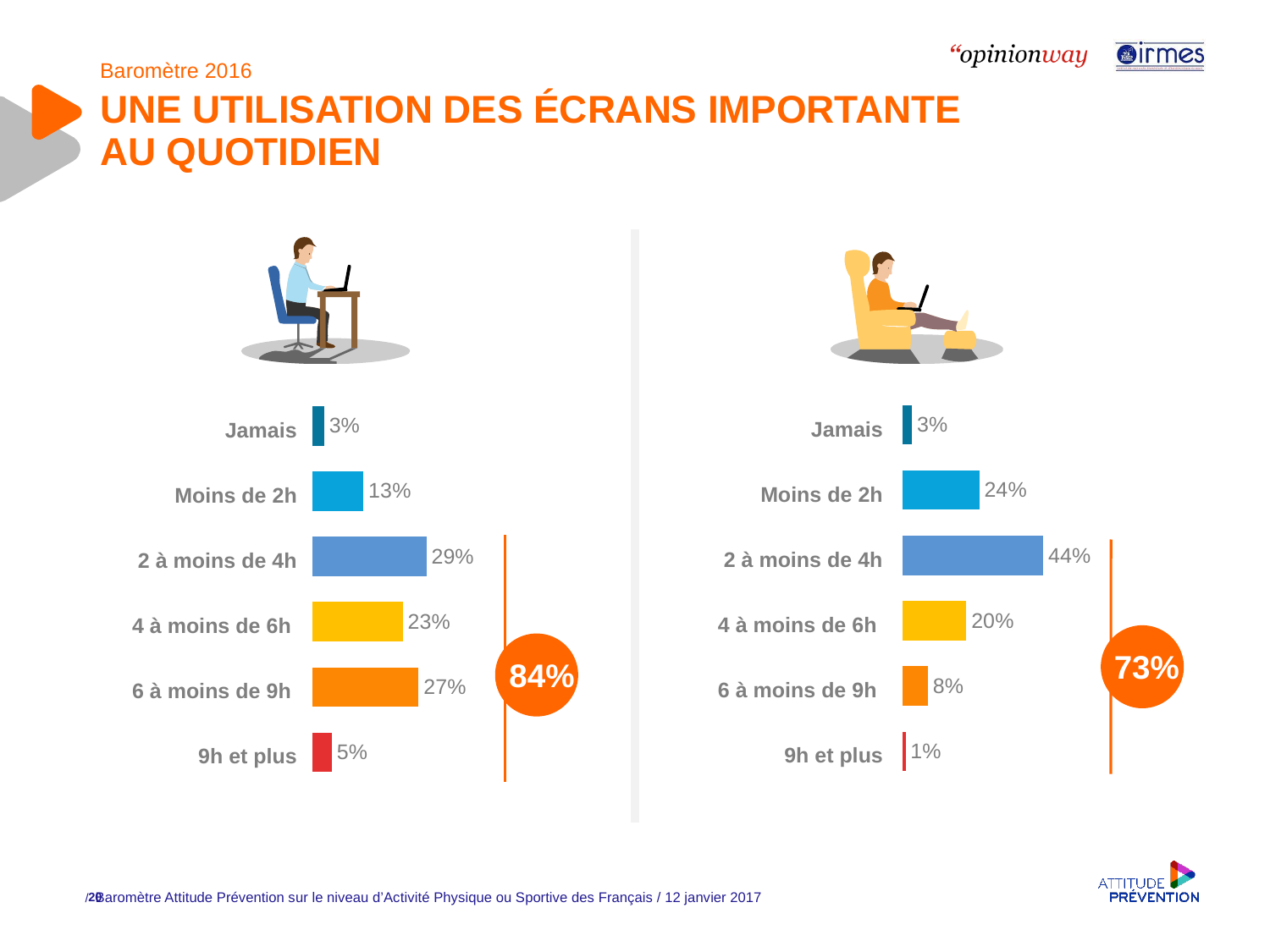
In the left chart, what is the value for '2 à moins de 4h'? 29% In the left chart, which category has the lowest value? Jamais What type of chart is the right chart? Bar chart In the right chart, what is the value for '9h et plus'? 1% In the left chart, what is the value for '6 à moins de 9h'? 27% In the right chart, which category has the lowest value? 9h et plus Which is larger: '6 à moins de 9h' in the left chart or '6 à moins de 9h' in the right chart? Left chart In the right chart, what is the difference between '2 à moins de 4h' and 'Moins de 2h'? 20% In the right chart, what is the value for 'Moins de 2h'? 24% In the right chart, which category has the highest value? 2 à moins de 4h How many categories does the left chart show? 6 In the left chart, what is the difference between '2 à moins de 4h' and '4 à moins de 6h'? 6%